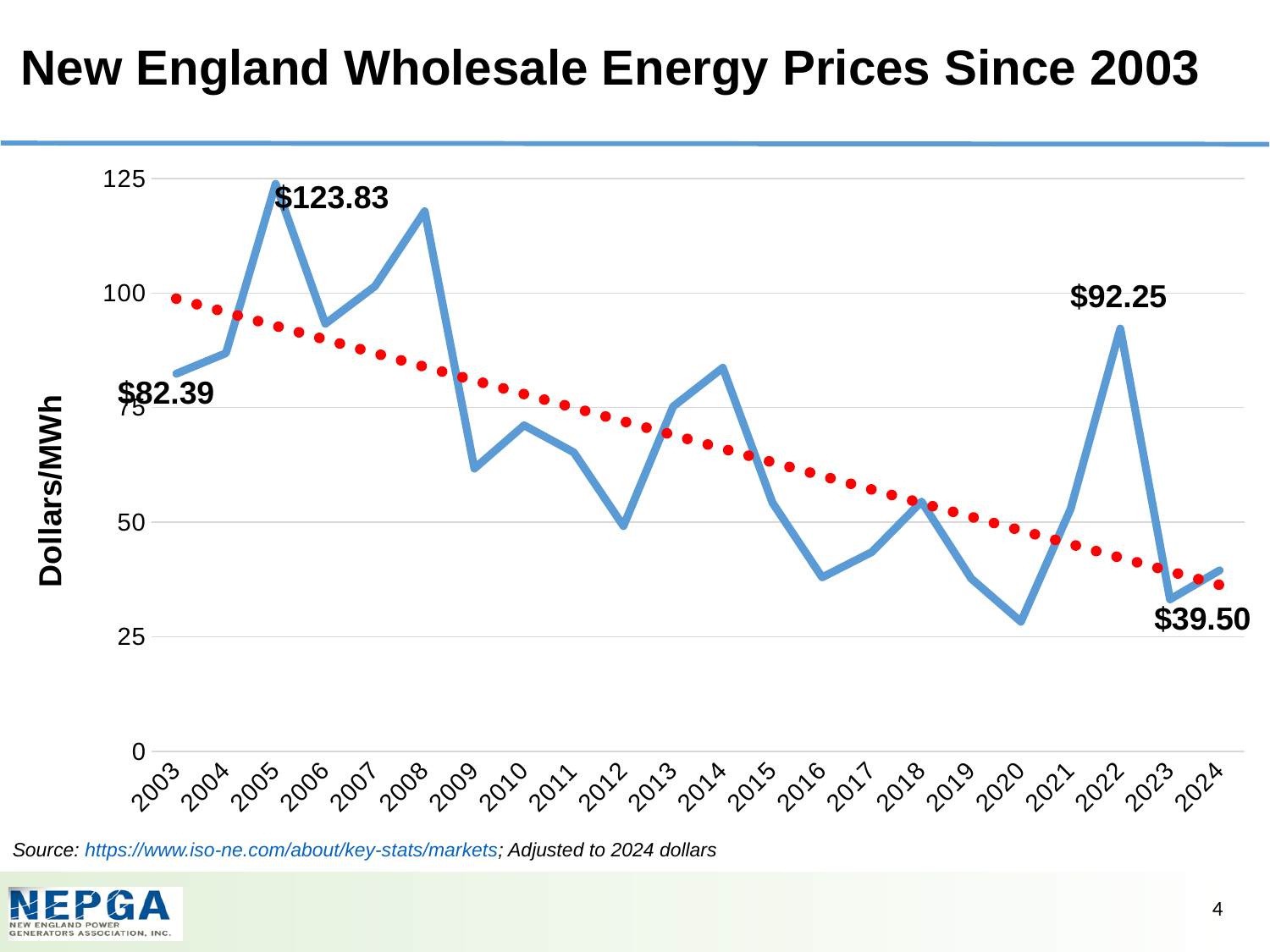
What was the New England wholesale energy price in 2003? $82.39 What was the wholesale energy price in 2022? $92.25 What kind of chart is shown on the slide? Line chart Which year has the highest wholesale energy price? 2005 What is the difference between the 2005 price and the 2024 price? $84.33 Is the value for 2016 greater or less than 50? less Which is larger, the price in 2003 or the price in 2022? 2022 Which year has the lowest wholesale energy price? 2020 Is the value for 2008 greater or less than 100? greater How many years are plotted on the x axis? 22 What value is labelled for 2005? $123.83 What was the wholesale energy price in 2024? $39.50